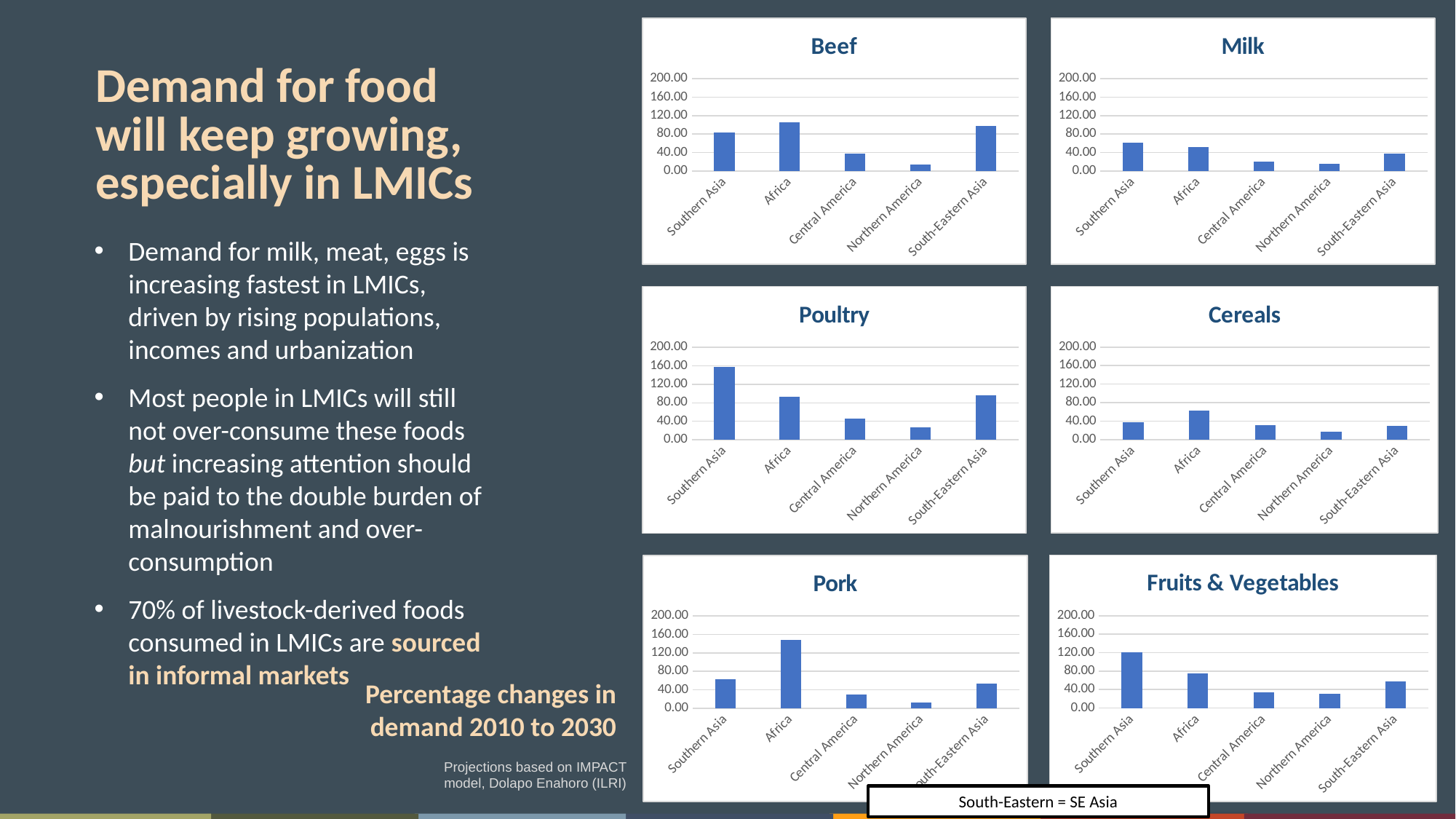
What kind of chart is the Pork chart? Bar chart In the Beef chart, which region has the highest value? Africa In the Poultry chart, which region has the highest value? Southern Asia In the Beef chart, which is larger, the value for Southern Asia or the value for Central America? Southern Asia In the Pork chart, which region has the highest value? Africa In the Pork chart, is the value for Africa greater or less than 120? greater In the Fruits & Vegetables chart, is the value for Southern Asia greater or less than 80? greater In the Beef chart, which region has the lowest value? Northern America In the Poultry chart, is the value for Southern Asia greater or less than 120? greater In the Cereals chart, which region has the lowest value? Northern America How many regions are shown on the x axis of the Poultry chart? 5